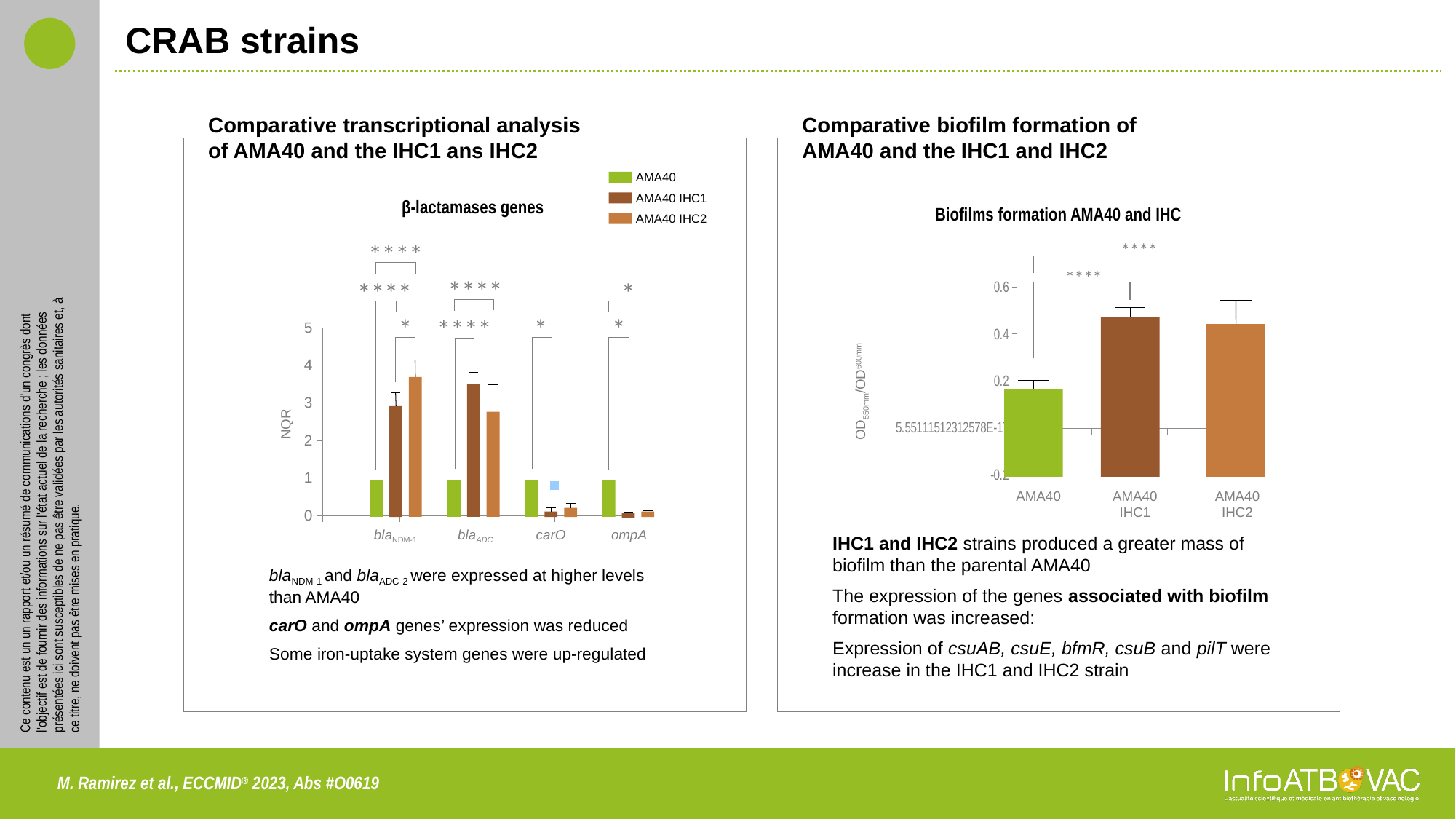
In the 'β-lactamases genes' chart, which is larger for blaNDM-1: AMA40 IHC1 or AMA40 IHC2? AMA40 IHC2 In the 'β-lactamases genes' chart, is the AMA40 IHC2 value for blaNDM-1 greater or less than 3? greater How many bars are shown in the 'Biofilms formation AMA40 and IHC' chart? 3 What kind of chart is the 'Biofilms formation AMA40 and IHC' chart on the right? bar chart In the 'β-lactamases genes' chart, which is larger for blaADC: AMA40 IHC1 or AMA40 IHC2? AMA40 IHC1 In the 'Biofilms formation AMA40 and IHC' chart, is the value for AMA40 IHC1 greater or less than 0.4? greater What kind of chart is the 'β-lactamases genes' chart on the left? bar chart In the 'β-lactamases genes' chart, is the AMA40 IHC1 value for carO greater or less than 1? less How many gene categories are shown on the x axis of the 'β-lactamases genes' chart? 4 How many series does the legend of the 'β-lactamases genes' chart list? 3 In the 'Biofilms formation AMA40 and IHC' chart, which strain has the lowest value? AMA40 What is the y-axis label of the 'β-lactamases genes' chart? NQR